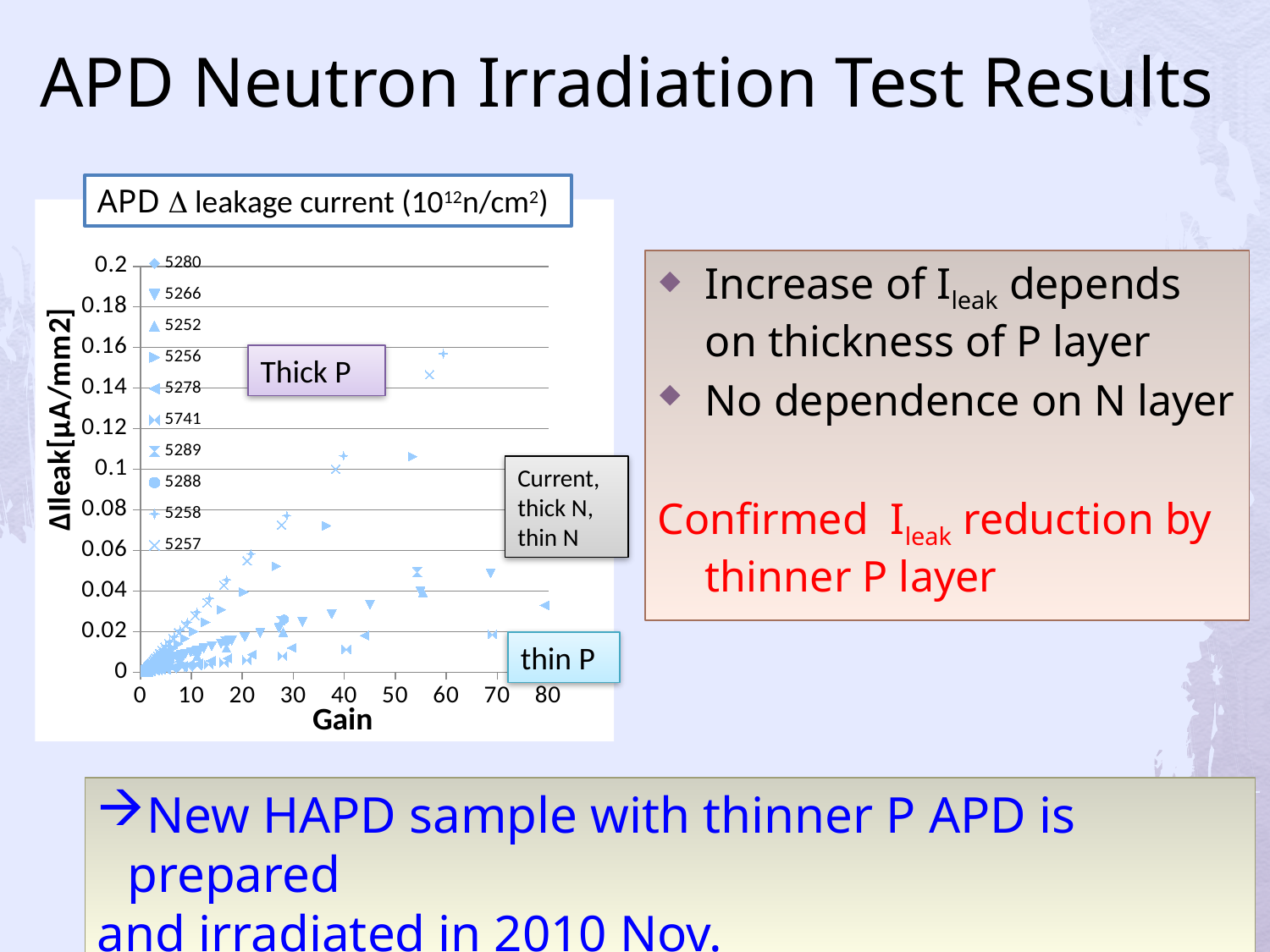
Is the highest ΔIleak value plotted on the chart greater or less than 0.14? greater Do the plotted ΔIleak values generally rise or fall as Gain increases? rise Is the highest ΔIleak value plotted on the chart greater or less than 0.18? less What is the label of the x axis of the chart? Gain What is the maximum value shown on the y axis of the chart? 0.2 What is the title of the chart? APD Δ leakage current (10^12 n/cm^2) What kind of chart is shown on the slide? scatter chart Which group of series, 'Thick P' or 'thin P', reaches higher ΔIleak values at a given Gain? Thick P Is the ΔIleak value of the highest point in the 'thin P' group (near Gain 80) greater or less than 0.06? less How many series does the chart legend list? 10